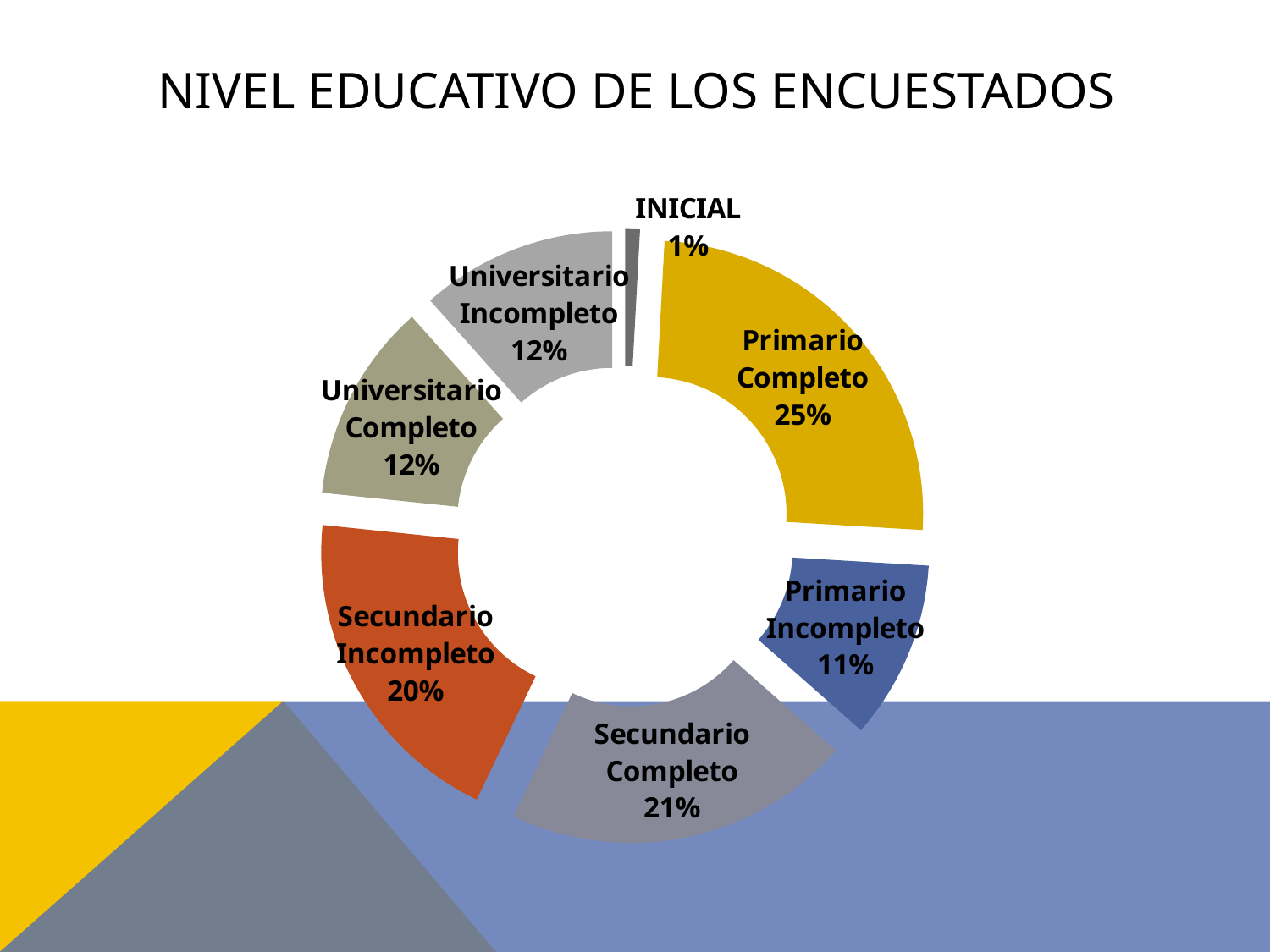
What colour is the Primario Completo segment? Yellow Which is larger, the share for Secundario Completo or the share for Secundario Incompleto? Secundario Completo How many education levels are shown in the chart? 7 Which education level has the smallest share of respondents? INICIAL What percentage of respondents have Primario Completo? 25% What is the difference in percentage points between Primario Completo and Secundario Completo? 4 What kind of chart is shown on the slide? Doughnut chart What percentage of respondents have Secundario Incompleto? 20% What percentage of respondents have Primario Incompleto? 11% What percentage of respondents have Universitario Completo? 12% What is the title of the slide? NIVEL EDUCATIVO DE LOS ENCUESTADOS Which education level has the largest share of respondents? Primario Completo